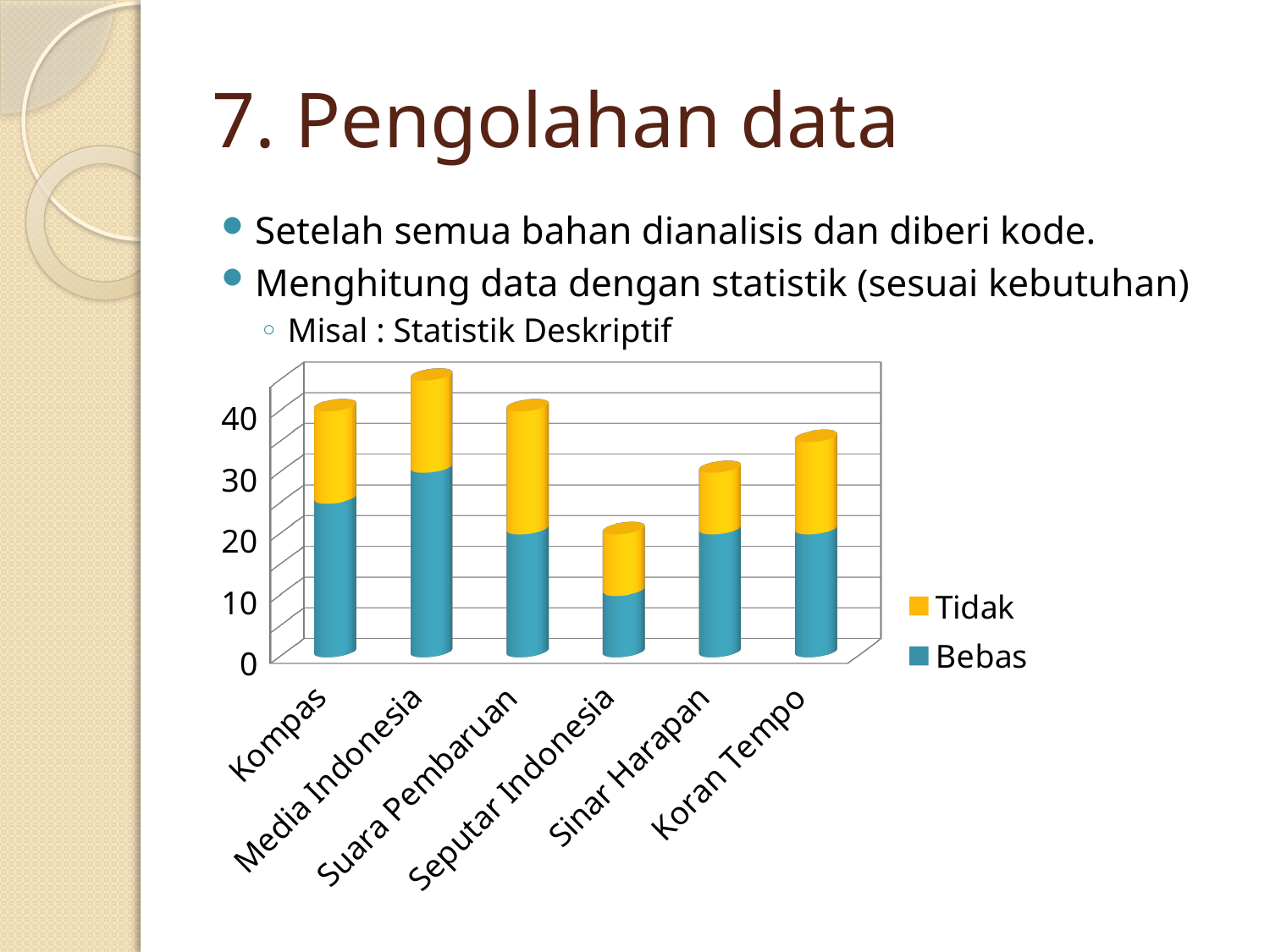
Which has a taller stacked bar, Kompas or Sinar Harapan? Kompas Which newspaper has the shortest stacked bar in the chart? Seputar Indonesia How many categories (newspapers) are shown on the x axis of the chart? 6 Is the total stacked value for Seputar Indonesia greater or less than 30? less Which has a taller stacked bar, Media Indonesia or Seputar Indonesia? Media Indonesia Which series is shown in yellow in the chart? Tidak How many series does the chart's legend list? 2 What are the two series names listed in the chart's legend? Tidak and Bebas Which newspaper has the tallest stacked bar in the chart? Media Indonesia Is the total stacked value for Media Indonesia greater or less than 40? greater Is the Bebas value for Seputar Indonesia greater or less than 20? less What kind of chart is shown on the slide? bar chart